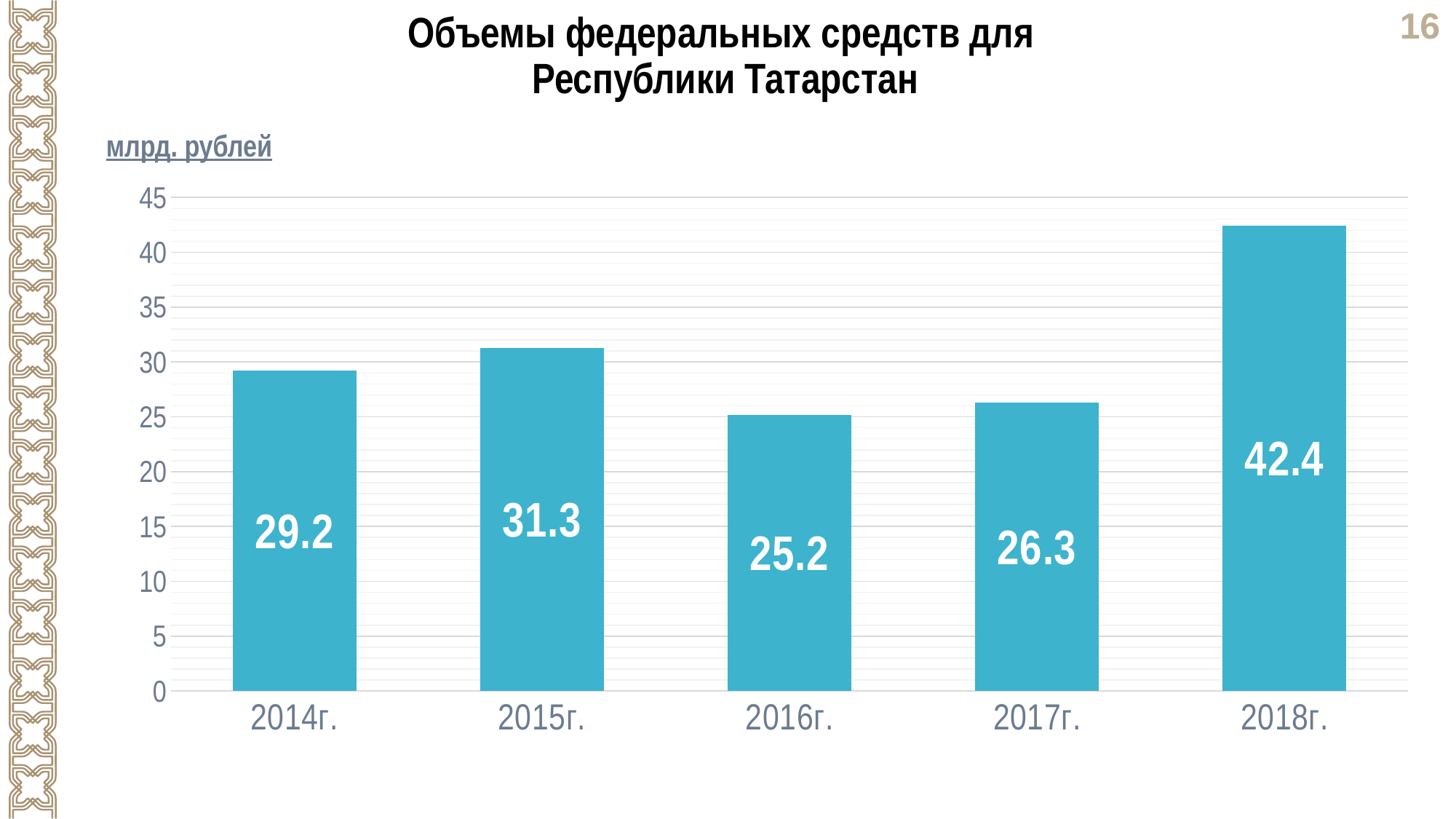
Which is larger, the value for 2015г. or the value for 2017г.? 2015г. Is the value for 2018г. greater or less than 40? greater Which year has the lowest value? 2016г. What is the difference between the values for 2018г. and 2017г.? 16.1 What is the value for 2016г.? 25.2 How many years are shown on the chart? 5 What is the value for 2014г.? 29.2 What is the difference between the values for 2015г. and 2014г.? 2.1 What unit is indicated above the chart? млрд. рублей What kind of chart is shown on the slide? bar chart Which year has the highest value? 2018г. What is the value for 2018г.? 42.4